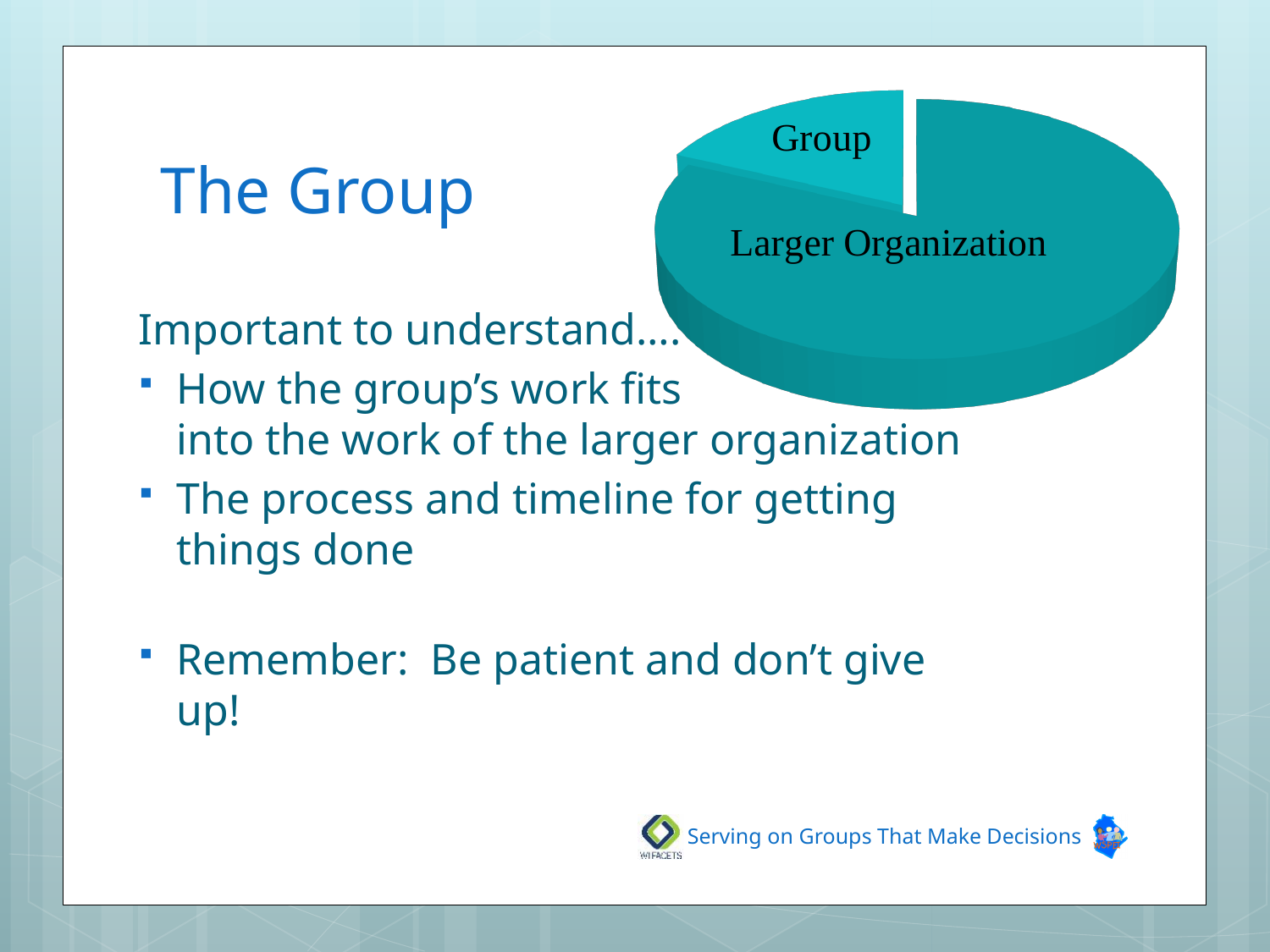
Which slice of the pie chart is the smallest? Group Which slice is larger in the pie chart, Group or Larger Organization? Larger Organization What kind of chart is shown on the slide? pie chart Is the pie chart drawn in 3D or flat 2D? 3D How many slices does the pie chart have? 2 Does the Larger Organization slice take up more or less than half of the pie chart? more What are the labels of the two slices in the pie chart? Group and Larger Organization Which slice of the pie chart is the largest? Larger Organization Does the Group slice take up more or less than half of the pie chart? less